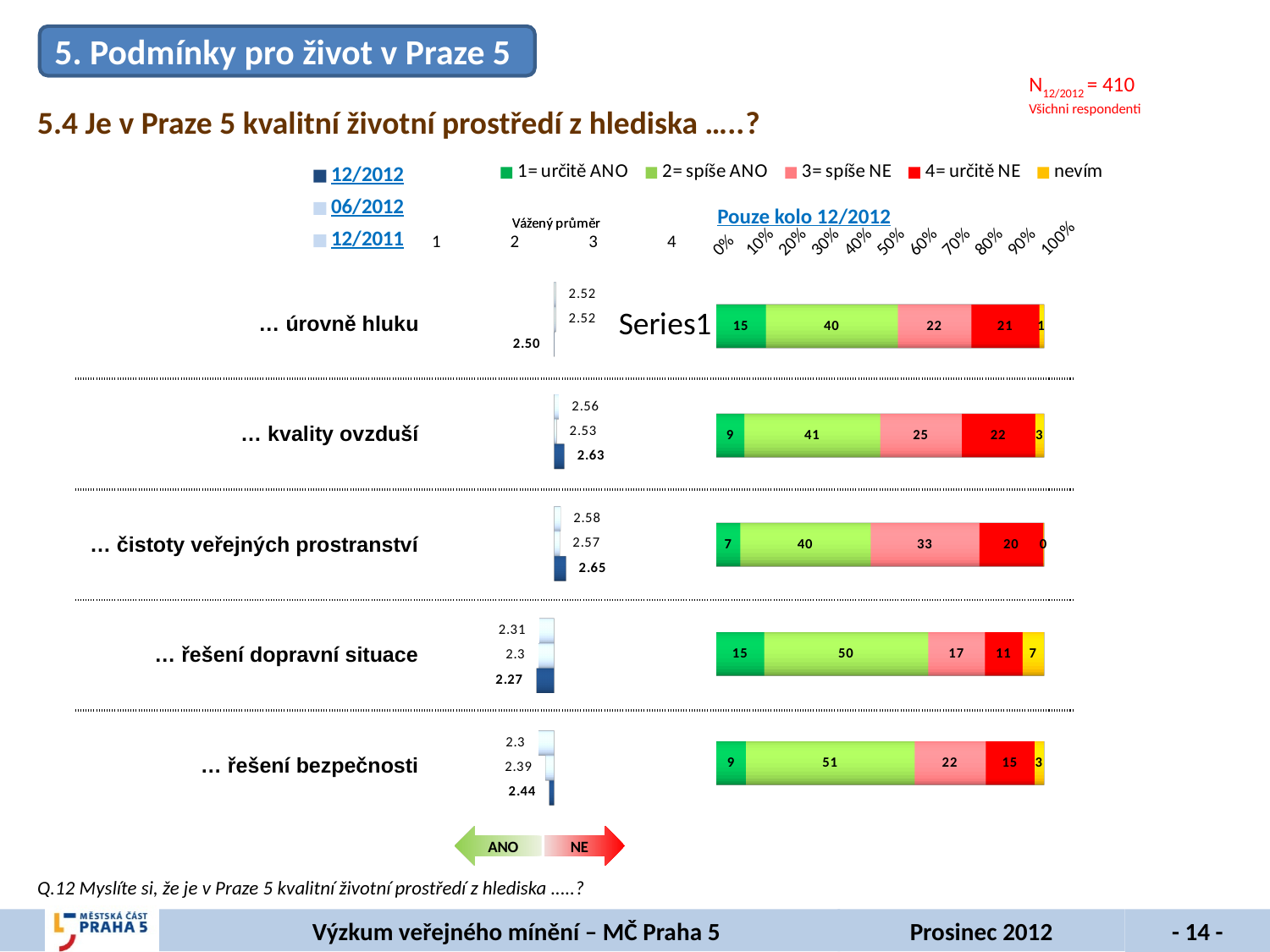
What type of chart is used for 'Pouze kolo 12/2012'? Stacked bar chart How many items (rows) are plotted in the stacked bar chart 'Pouze kolo 12/2012'? 5 In the stacked bar chart 'Pouze kolo 12/2012', what percentage answered '1= určitě ANO' for '… úrovně hluku'? 15 In the 'Vážený průměr' chart, what is the 12/2012 (bold) weighted average for '… kvality ovzduší'? 2.63 How many answer categories does the legend of the stacked bar chart list? 5 In the stacked bar chart 'Pouze kolo 12/2012', which has a larger '3= spíše NE' value: '… kvality ovzduší' or '… řešení bezpečnosti'? … kvality ovzduší In the stacked bar chart 'Pouze kolo 12/2012', what is the value of '3= spíše NE' for '… čistoty veřejných prostranství'? 33 In the stacked bar chart 'Pouze kolo 12/2012', what is the difference between the '4= určitě NE' values for '… úrovně hluku' and '… řešení dopravní situace'? 10 In the 'Vážený průměr' chart, which item has the lowest 12/2012 (bold) weighted average? … řešení dopravní situace In the stacked bar chart 'Pouze kolo 12/2012', what is the 'nevím' value for '… řešení dopravní situace'? 7 In the stacked bar chart 'Pouze kolo 12/2012', which item has the highest '2= spíše ANO' value? … řešení bezpečnosti In the stacked bar chart 'Pouze kolo 12/2012', what is the total of the segments for '… řešení dopravní situace'? 100